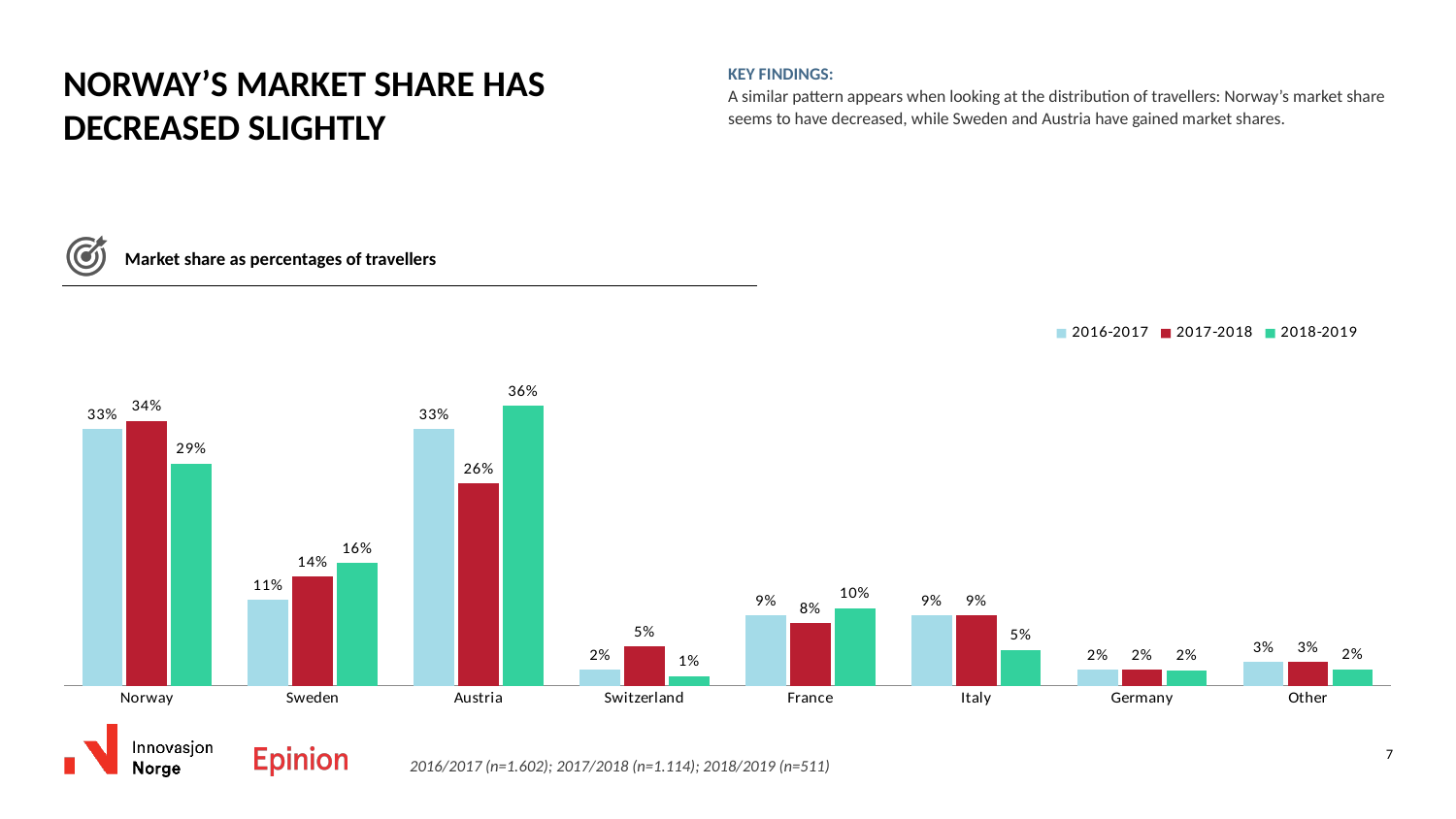
What is Sweden's market share for 2016-2017? 11% Which country has the highest market share in the 2018-2019 series? Austria How many countries/categories are shown on the x axis? 8 What kind of chart is shown on the slide? Bar chart What is the title of the chart? Market share as percentages of travellers Do Sweden's values rise or fall from 2016-2017 to 2018-2019? Rise Which is larger: Norway's 2017-2018 share or Austria's 2017-2018 share? Norway's 2017-2018 share How many series does the legend list? 3 What is the difference between Austria's 2018-2019 share and its 2017-2018 share? 10% What is Norway's market share for 2018-2019? 29% Which category has the lowest value in the 2018-2019 series? Switzerland What is Austria's market share for 2017-2018? 26%